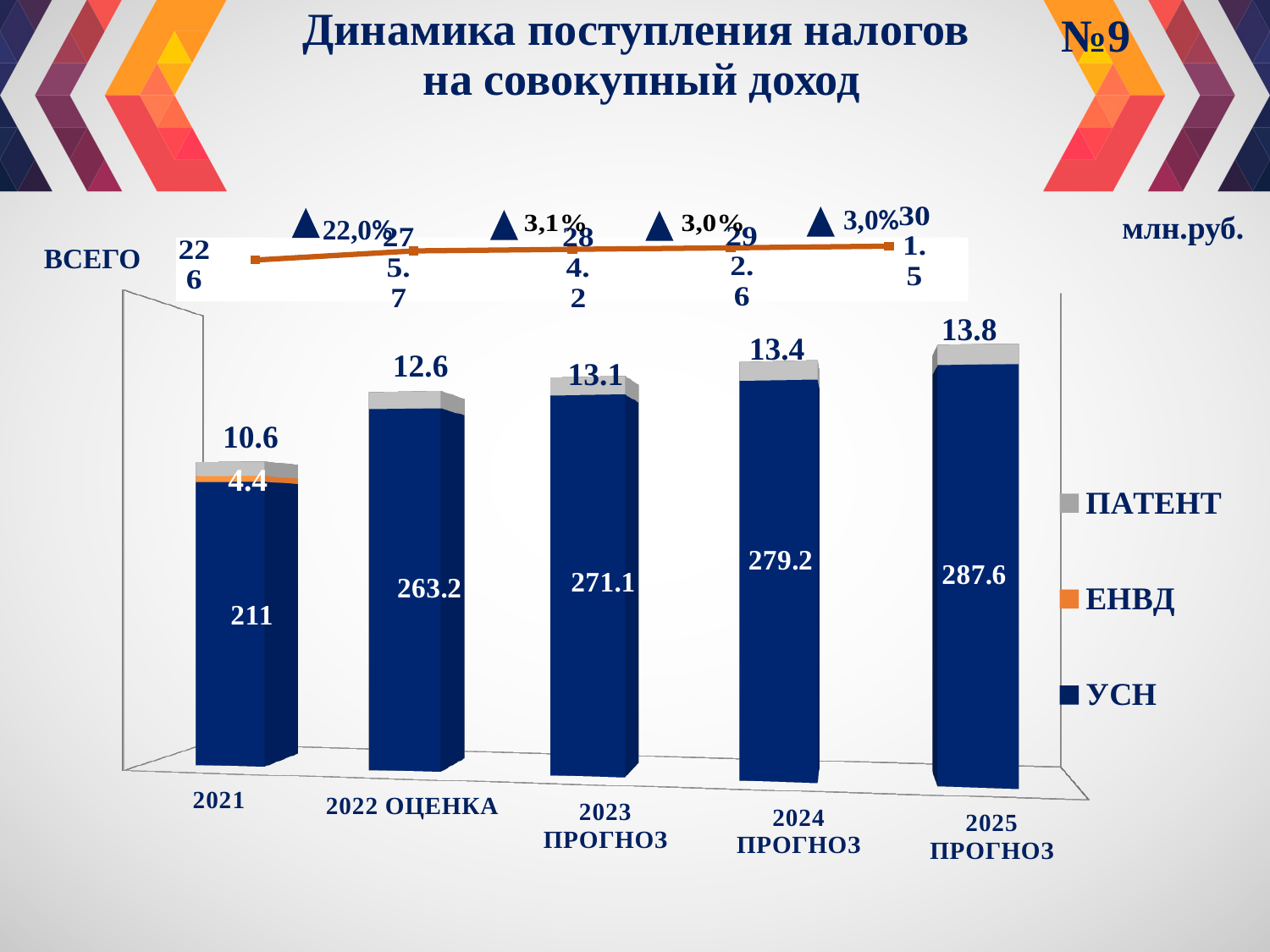
What is the УСН value for 2021? 211 What is the ЕНВД value for 2021? 4.4 How many categories (years) are shown on the x axis? 5 Which is larger, the ПАТЕНТ value for 2023 ПРОГНОЗ or for 2024 ПРОГНОЗ? 2024 ПРОГНОЗ What type of chart is shown on the slide? stacked bar chart How many series does the legend list? 3 What is the УСН value for 2025 ПРОГНОЗ? 287.6 Which year has the lowest ПАТЕНТ value? 2021 Which year has the highest УСН value? 2025 ПРОГНОЗ What is the ПАТЕНТ value for 2022 ОЦЕНКА? 12.6 Do the УСН values rise or fall from 2021 to 2025 ПРОГНОЗ? rise What is the difference between the УСН values for 2025 ПРОГНОЗ and 2024 ПРОГНОЗ? 8.4